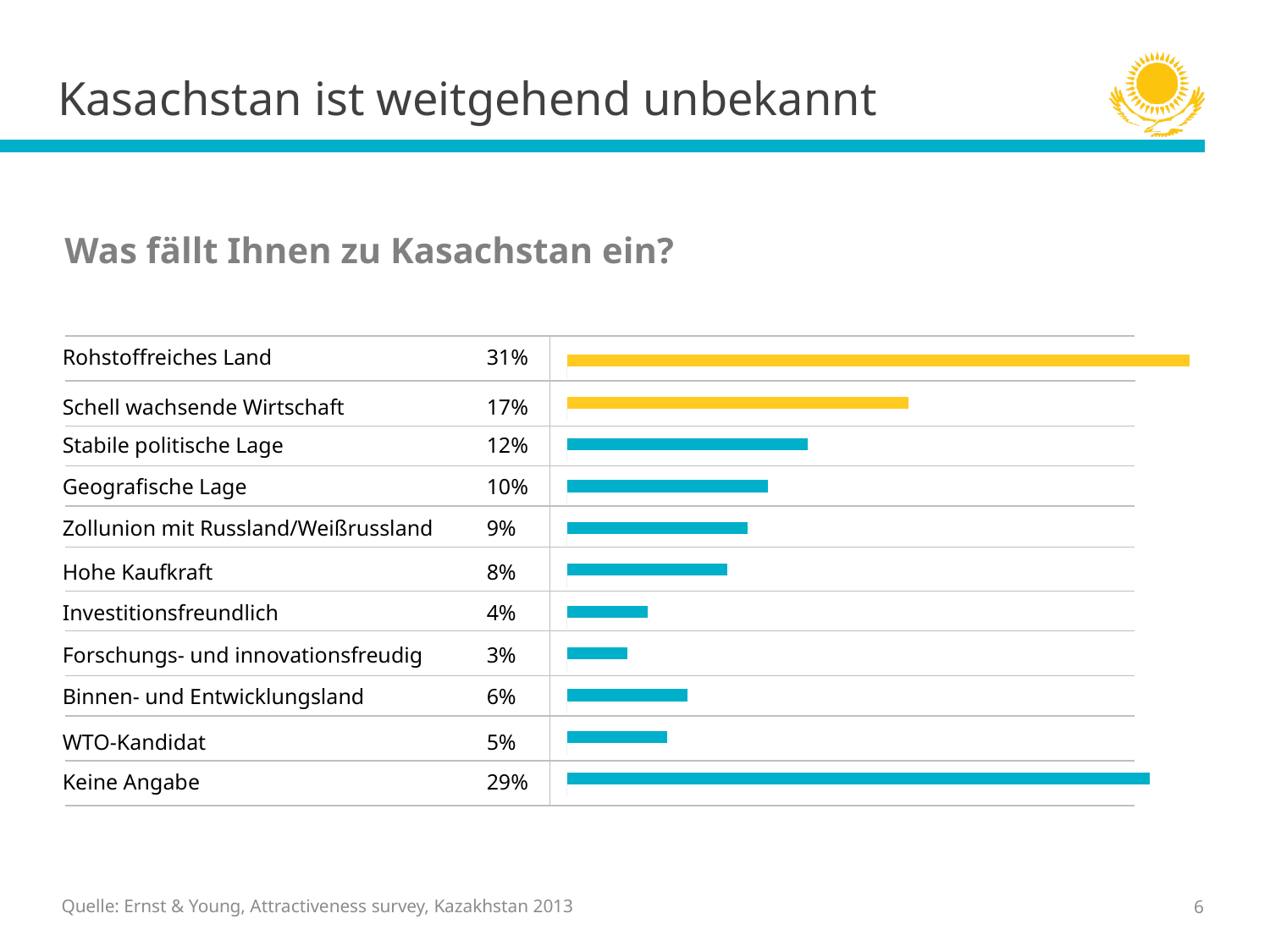
Which two categories are shown with yellow bars instead of blue? Rohstoffreiches Land and Schell wachsende Wirtschaft Which is larger, "Binnen- und Entwicklungsland" or "WTO-Kandidat"? Binnen- und Entwicklungsland Which is larger, "Hohe Kaufkraft" or "Investitionsfreundlich"? Hohe Kaufkraft What kind of chart is shown on the slide? Bar chart What is the value for "Zollunion mit Russland/Weißrussland"? 9% Which category has the highest value? Rohstoffreiches Land Which category has the lowest value? Forschungs- und innovationsfreudig What is the difference between "Stabile politische Lage" and "Geografische Lage"? 2 percentage points How many categories are shown in the chart? 11 What is the difference between "Rohstoffreiches Land" and "Schell wachsende Wirtschaft"? 14 percentage points What percentage of respondents associate Kazakhstan with "Rohstoffreiches Land"? 31% What is the value for "Keine Angabe"? 29%